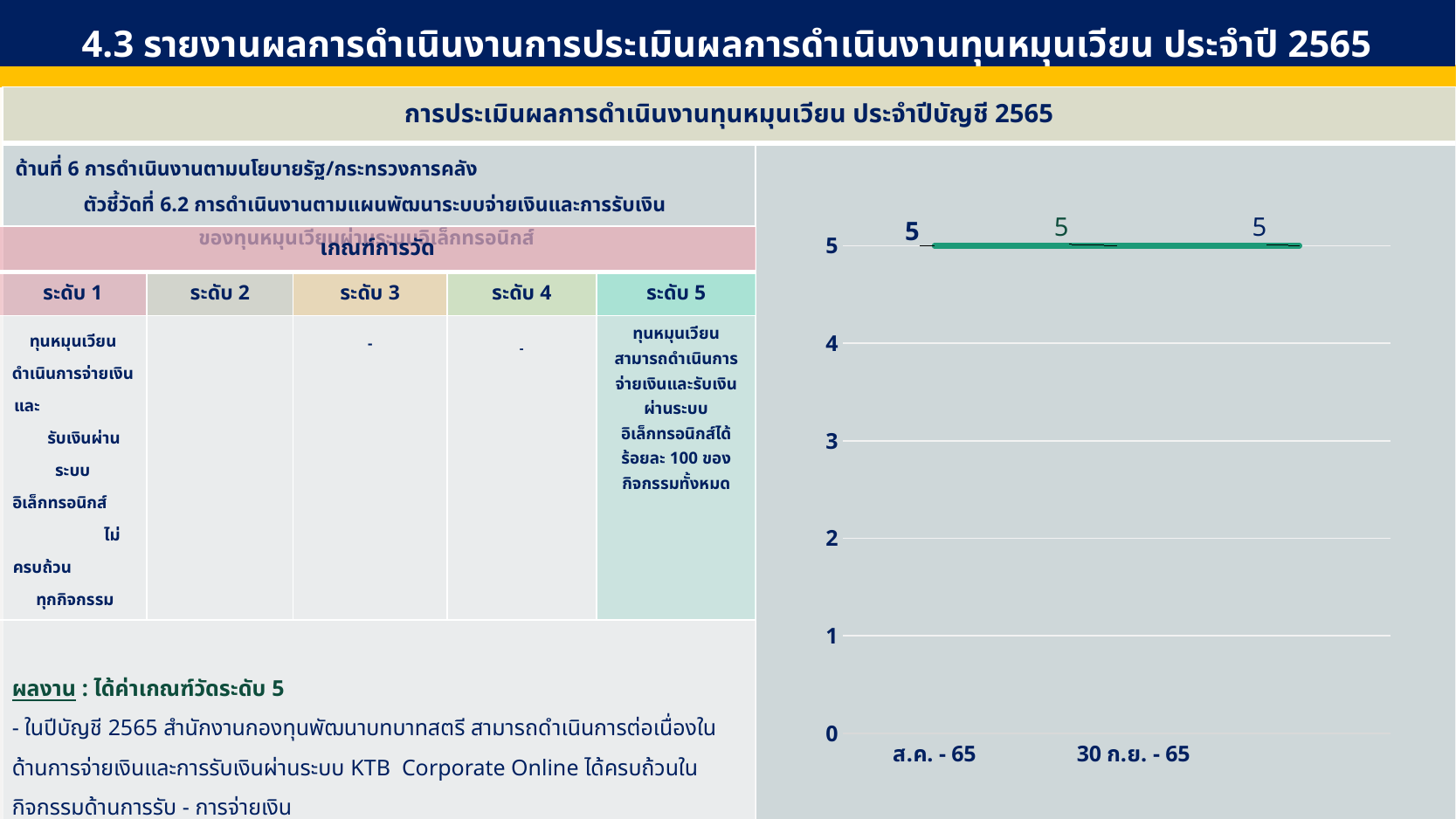
How many data points are plotted on the line in the chart? 3 Is the value for ส.ค. - 65 greater or less than 4? greater What is the difference between the values for ส.ค. - 65 and 30 ก.ย. - 65 in the chart? 0 What is the lowest tick shown on the vertical axis of the chart? 0 What is the highest tick shown on the vertical axis of the chart? 5 What kind of chart is shown on the right side of the slide? line chart Do the values in the chart rise, fall, or stay flat from left to right? stay flat What is the value plotted for ส.ค. - 65 in the chart? 5 What value is shown by the data labels on every point of the line in the chart? 5 What is the value plotted for 30 ก.ย. - 65 in the chart? 5